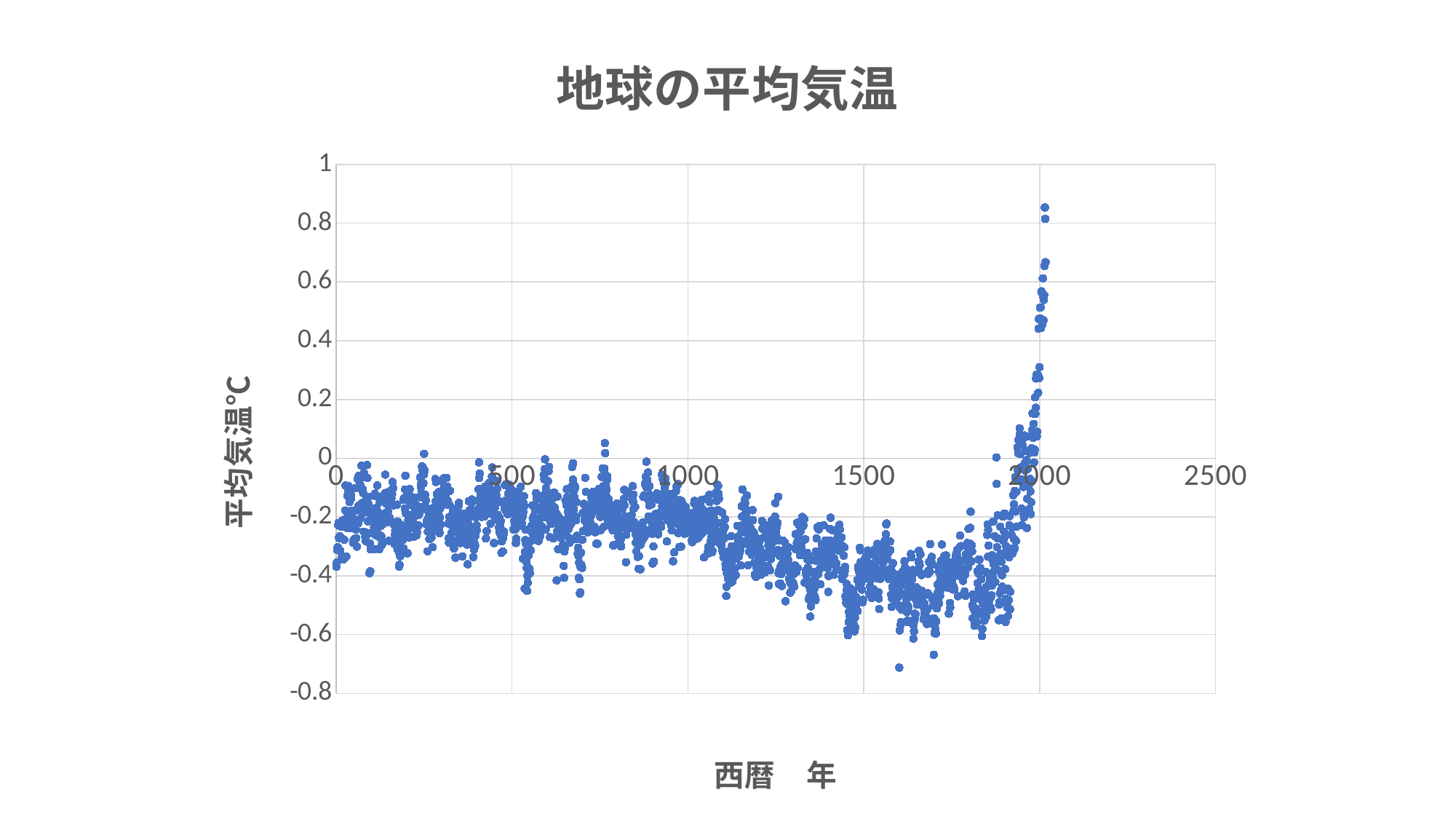
Are the plotted values around year 1600 greater or less than 0? less Are the plotted values around year 500 greater or less than 0.2? less What is the title of the chart? 地球の平均気温 Do the plotted values generally rise or fall as the year goes from 1000 to 1600? fall What kind of chart is shown on the slide? scatter chart Is the highest plotted value on the chart greater or less than 0.6? greater What is the label of the vertical axis? 平均気温℃ Do the plotted values rise or fall as the year goes from 1900 toward 2000? rise